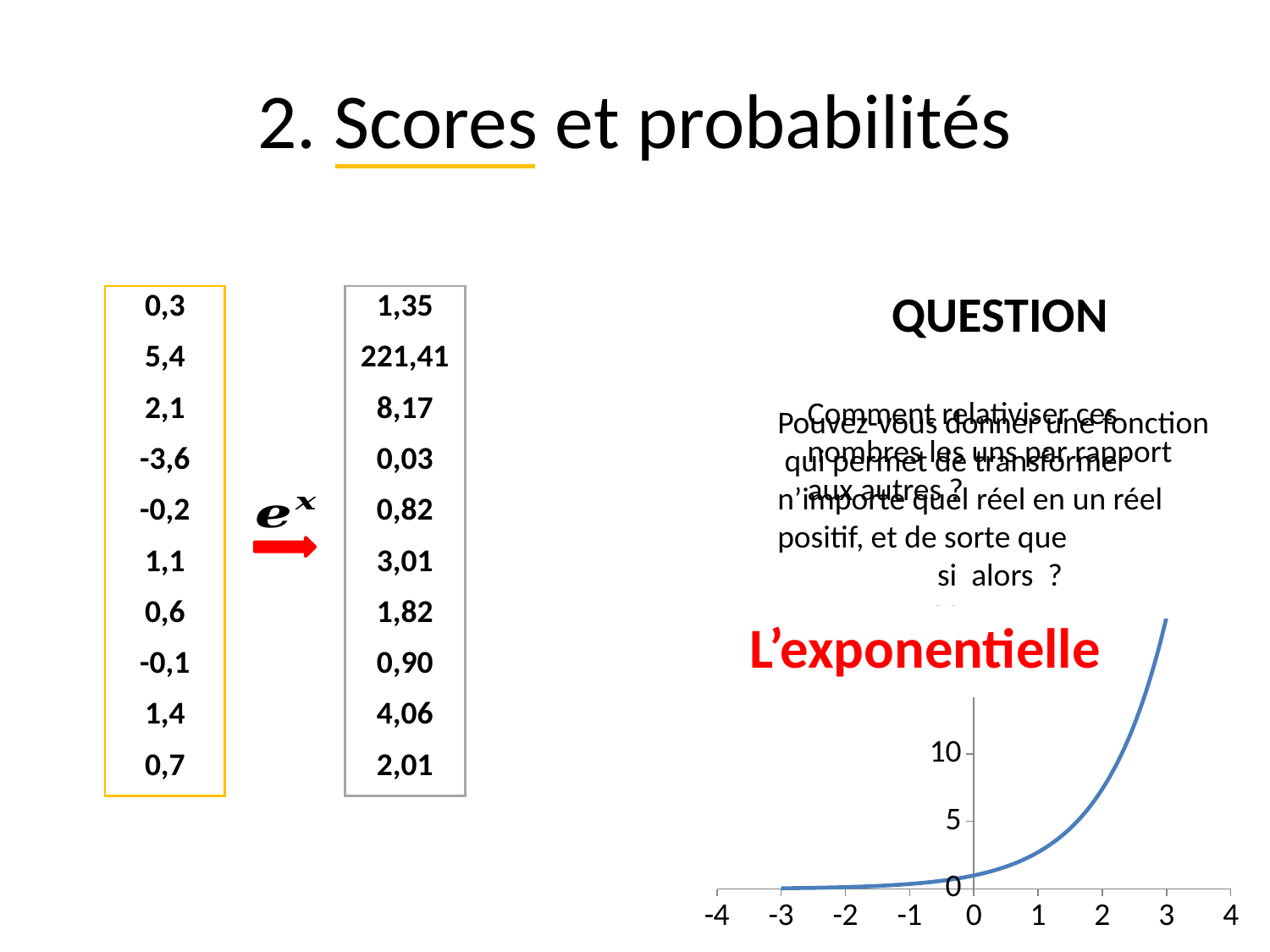
Is the value of the curve at x = 3 greater or less than 10? greater Which is larger on the chart: the value at x = 2 or the value at x = -2? x = 2 Do the values on the chart rise or fall as x increases from -3 to 3? rise What colour is the curve plotted on the chart? blue Is the value of the curve at x = 1 greater or less than 5? less At which x value shown on the chart does the curve reach its highest point? 3 At which x value shown on the chart does the curve reach its lowest point? -3 How many tick labels are shown on the x axis of the chart? 9 Is the value of the curve at x = -2 greater or less than 5? less What kind of chart is shown at the bottom right of the slide? line chart What is the highest tick label shown on the y axis of the chart? 10